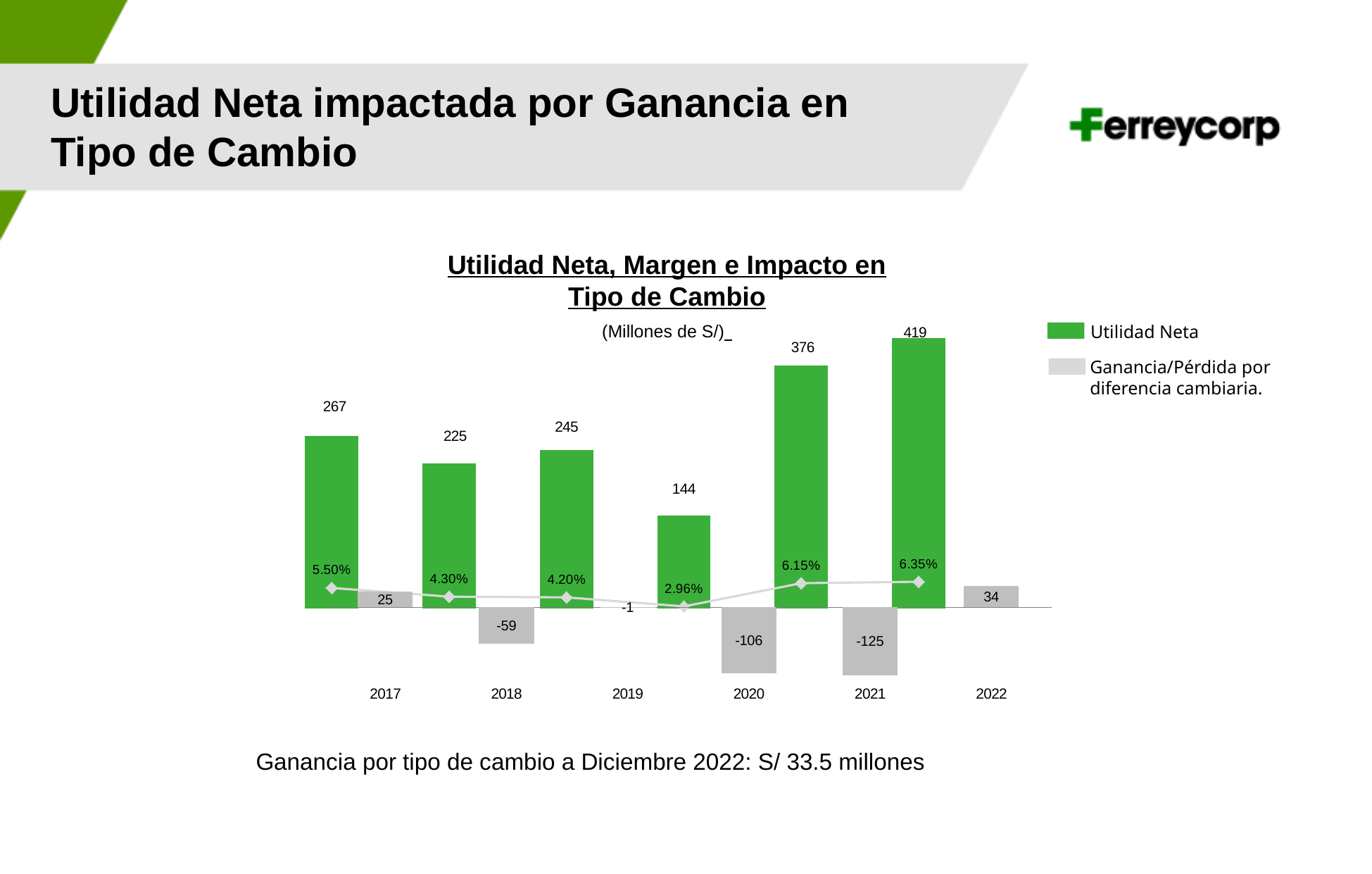
What unit is stated below the chart title? Millones de S/ Which is larger, the Utilidad Neta for 2017 or for 2019? 2017 How many series does the legend list? 2 What is the Utilidad Neta value for 2020? 144 What is the Ganancia/Pérdida por diferencia cambiaria value for 2021? -125 What is the difference between the Utilidad Neta for 2022 and 2021? 43 How many years are shown on the x axis? 6 Which year has the highest Utilidad Neta? 2022 Which year has the lowest Utilidad Neta? 2020 What kind of chart is used for the Utilidad Neta series? Bar chart What margin percentage is shown for 2019? 4.20% Does the Utilidad Neta rise or fall from 2020 to 2022? Rise